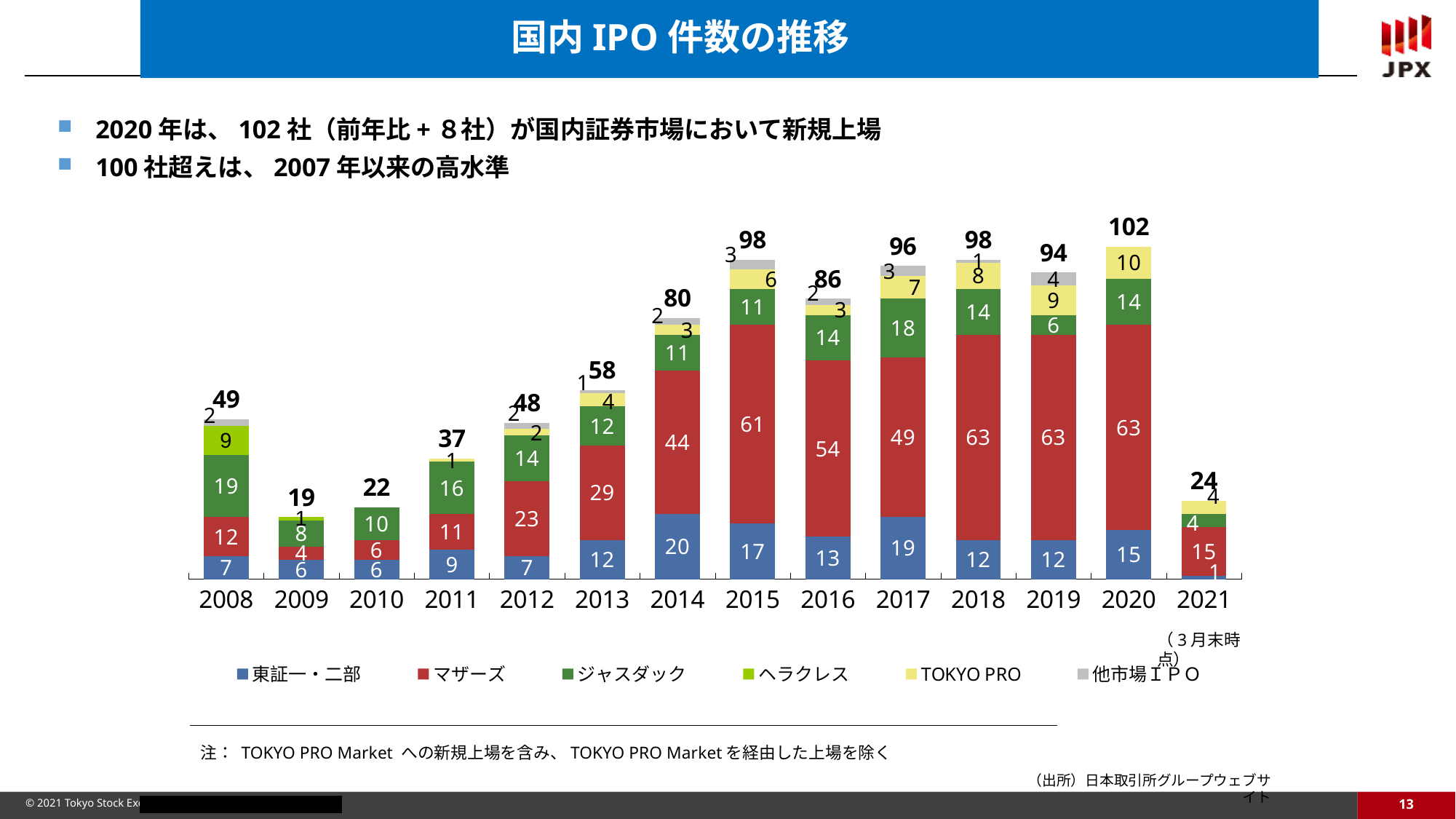
What kind of chart is shown on the slide? Stacked bar chart What is the value for 東証一・二部 in 2014? 20 Which year has the lowest total number of IPOs? 2009 Which is larger, the total for 2016 or the total for 2017? 2017 What is the value for ジャスダック in 2017? 18 Which year has the highest total number of IPOs? 2020 What is the total number of IPOs shown for 2020? 102 How many series does the legend list? 6 What is the value for マザーズ in 2015? 61 What is the value for TOKYO PRO in 2020? 10 What is the difference between the total for 2020 and the total for 2019? 8 How many years are shown on the x axis? 14